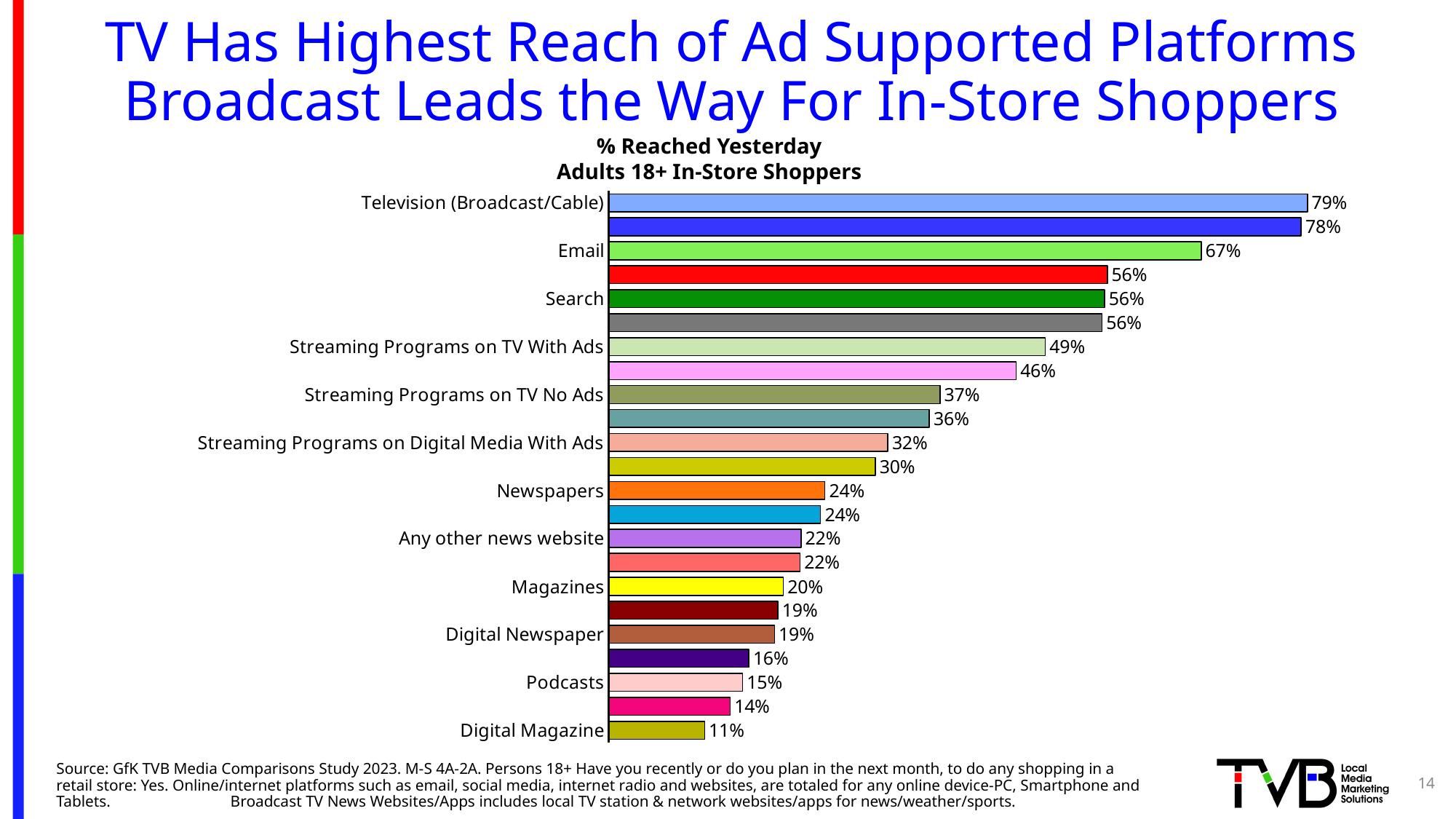
What is the value for Email? 67% What is the difference between the values for Television (Broadcast/Cable) and Email? 12 percentage points Which labeled category has the highest value? Television (Broadcast/Cable) How many bars are plotted in the chart? 23 What is the value for Digital Magazine? 11% Which labeled category has the lowest value? Digital Magazine Which is larger, the value for Search or the value for Streaming Programs on TV No Ads? Search What is the value for Podcasts? 15% What kind of chart is shown on the slide? Bar chart What is the subtitle printed above the chart? % Reached Yesterday Adults 18+ In-Store Shoppers What is the % reached yesterday for Television (Broadcast/Cable)? 79% What is the value for Streaming Programs on TV With Ads? 49%